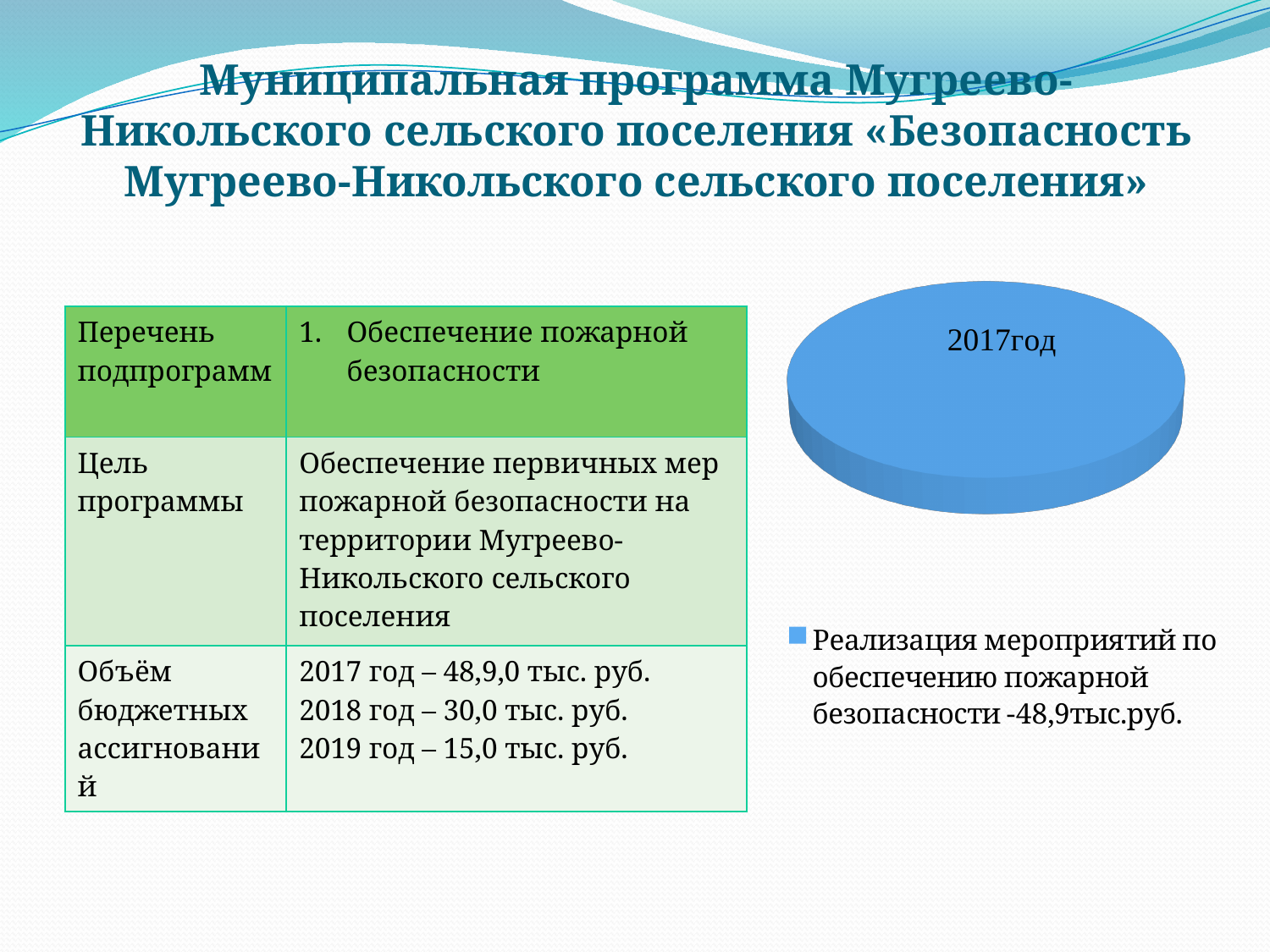
What label is printed on the pie chart's slice? 2017год What colour is the single slice of the pie chart? blue According to the legend of the pie chart, what is the value for "Реализация мероприятий по обеспечению пожарной безопасности"? 48,9тыс.руб. What share of the pie chart does the slice for "Реализация мероприятий по обеспечению пожарной безопасности" take up? 100% How many entries does the legend of the pie chart list? 1 What kind of chart is shown on the right side of the slide? pie chart How many slices does the pie chart contain? 1